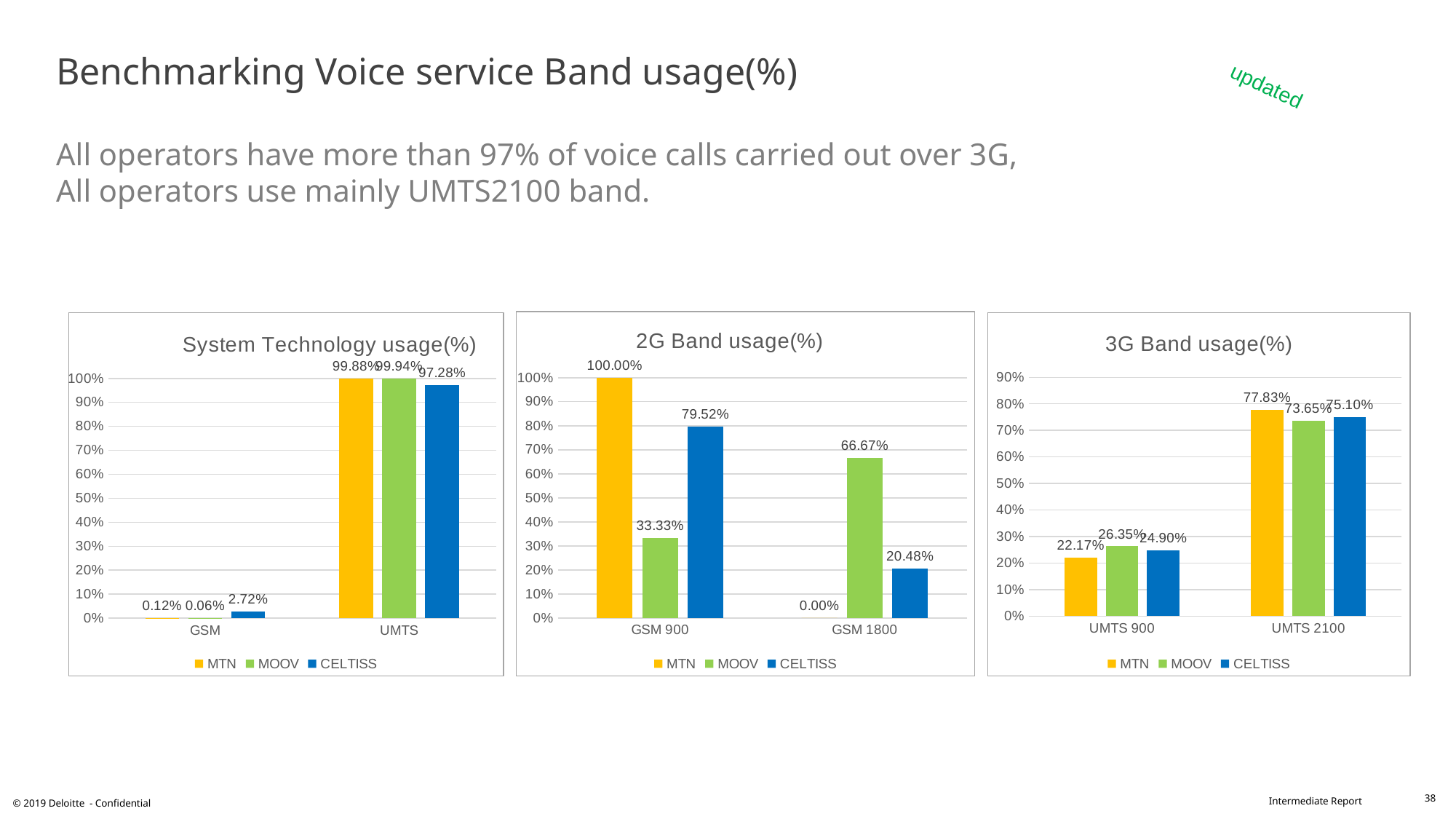
In the 3G Band usage(%) chart, which operator has the lowest value at UMTS 900? MTN In the 3G Band usage(%) chart, what colour represents CELTISS? blue In the 3G Band usage(%) chart, what is the value for MOOV at UMTS 2100? 73.65% In the 2G Band usage(%) chart, what is the value for MTN at GSM 900? 100.00% In the 2G Band usage(%) chart, what is the difference between the CELTISS values at GSM 900 and GSM 1800? 59.04% What kind of chart is the System Technology usage(%) chart? bar chart How many categories are shown on the x axis of the 2G Band usage(%) chart? 2 In the System Technology usage(%) chart, what is the value for CELTISS at GSM? 2.72% In the 2G Band usage(%) chart, which operator has the highest value at GSM 1800? MOOV How many series does the legend of the 3G Band usage(%) chart list? 3 In the 3G Band usage(%) chart, which is larger at UMTS 2100: MTN or CELTISS? MTN In the 2G Band usage(%) chart, is the value for MOOV at GSM 900 greater or less than 40%? less